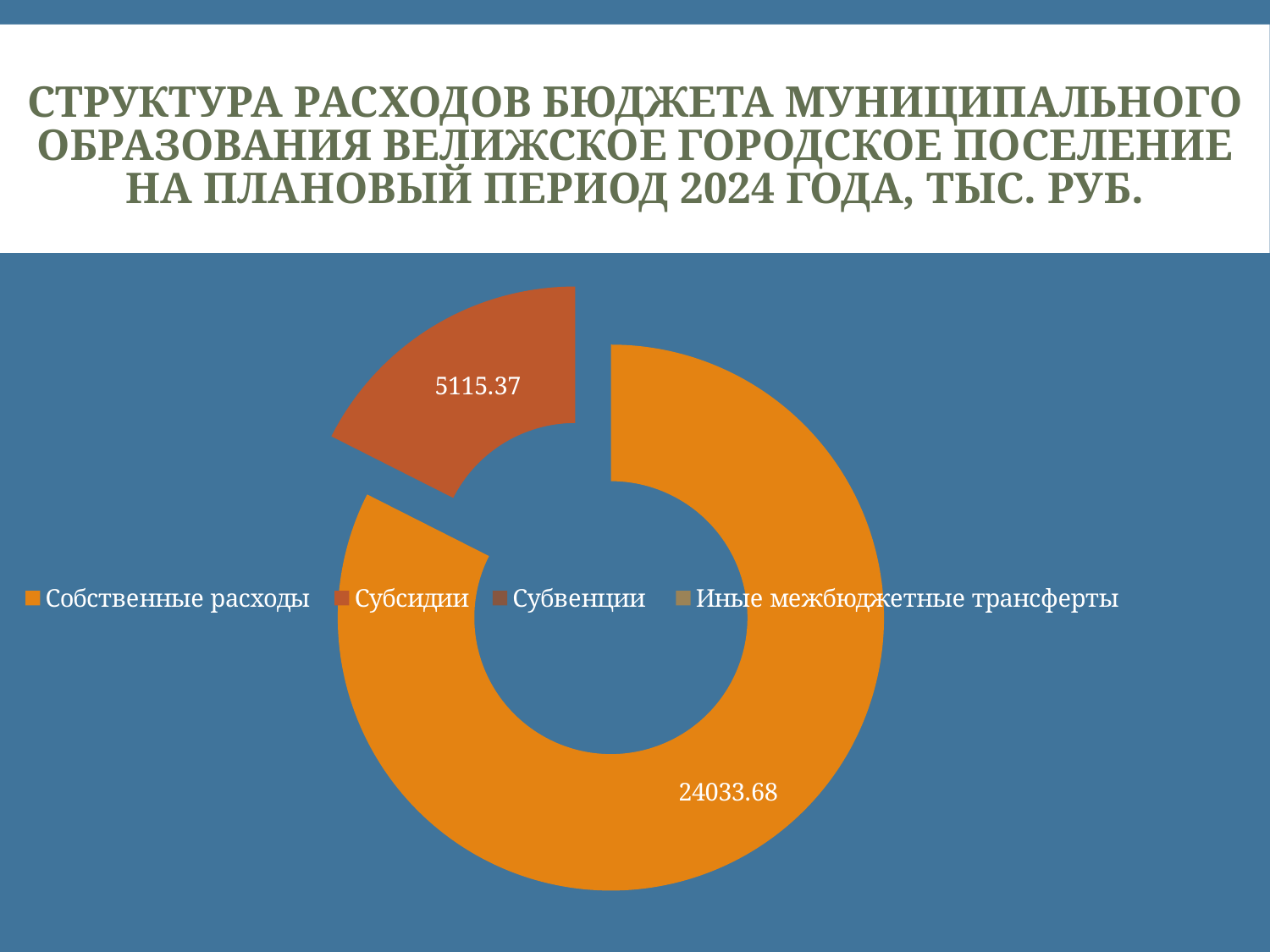
Which category has the largest slice in the chart? Собственные расходы What is the difference between the two labelled slice values, 24033.68 and 5115.37? 18918.31 What kind of chart is shown on the slide? doughnut chart Which legend entry is listed first? Собственные расходы Which is larger: the slice labelled 24033.68 or the slice labelled 5115.37? 24033.68 How many slices with data labels are visible in the doughnut chart? 2 What value is shown for Собственные расходы? 24033.68 How many entries does the legend list? 4 What unit of measurement is stated in the slide title? тыс. руб. What value is printed on the smaller, separated slice of the doughnut? 5115.37